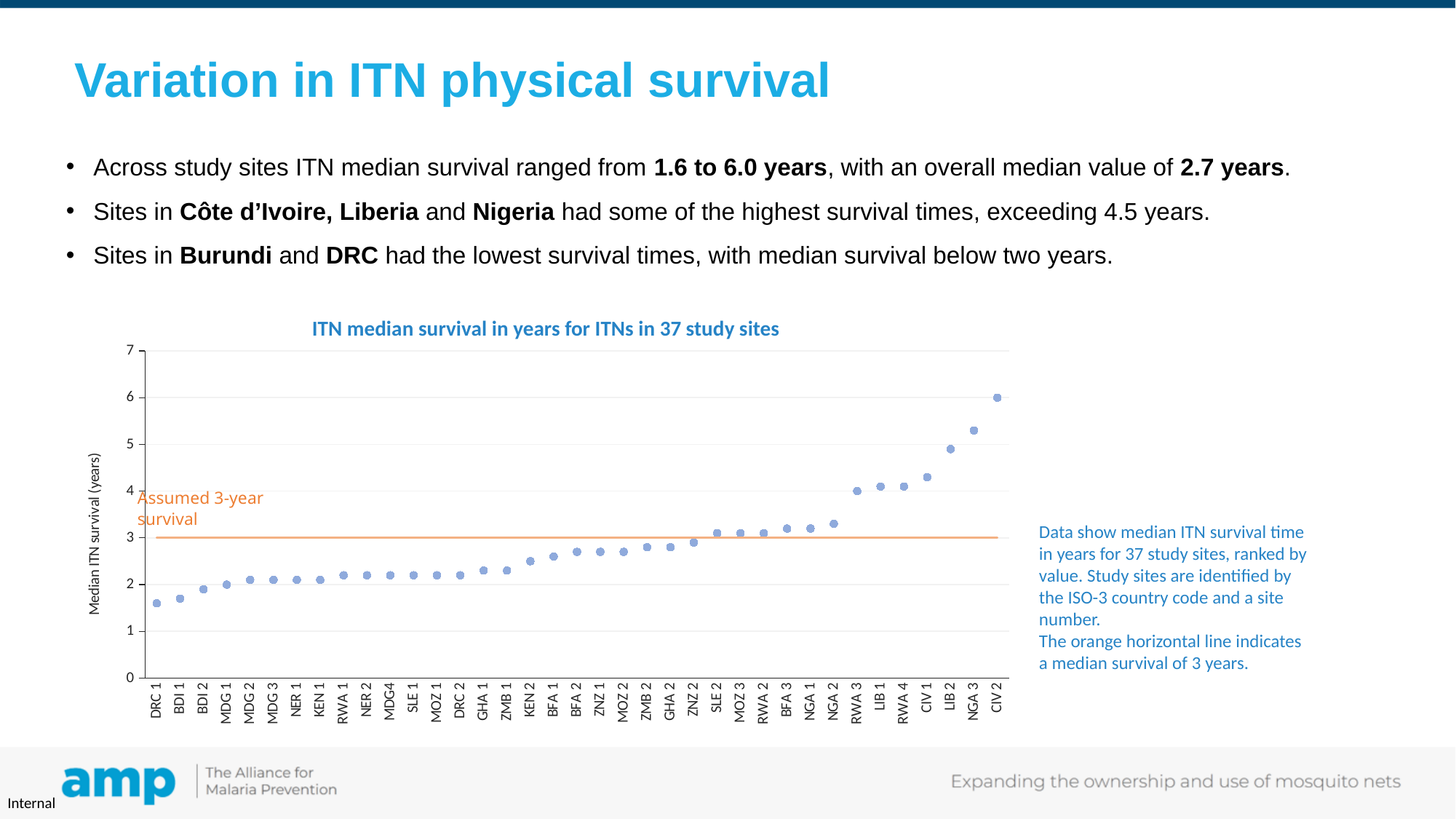
Is the value for LIB 2 greater or less than 4? greater Is the value for DRC 1 greater or less than 2? less How many study sites are plotted on the x axis of the chart? 37 What is the title of the chart? ITN median survival in years for ITNs in 37 study sites Which study site has the lowest median ITN survival in the chart? DRC 1 Which study site has the highest median ITN survival in the chart? CIV 2 Is the value for KEN 2 greater or less than 3? less Which has a higher median ITN survival, CIV 1 or LIB 2? LIB 2 What does the orange horizontal line in the chart represent? Assumed 3-year survival Do the plotted values rise or fall from left to right along the x axis? Rise What is the median ITN survival in years for CIV 2? 6 What kind of chart is shown on the slide? Scatter chart